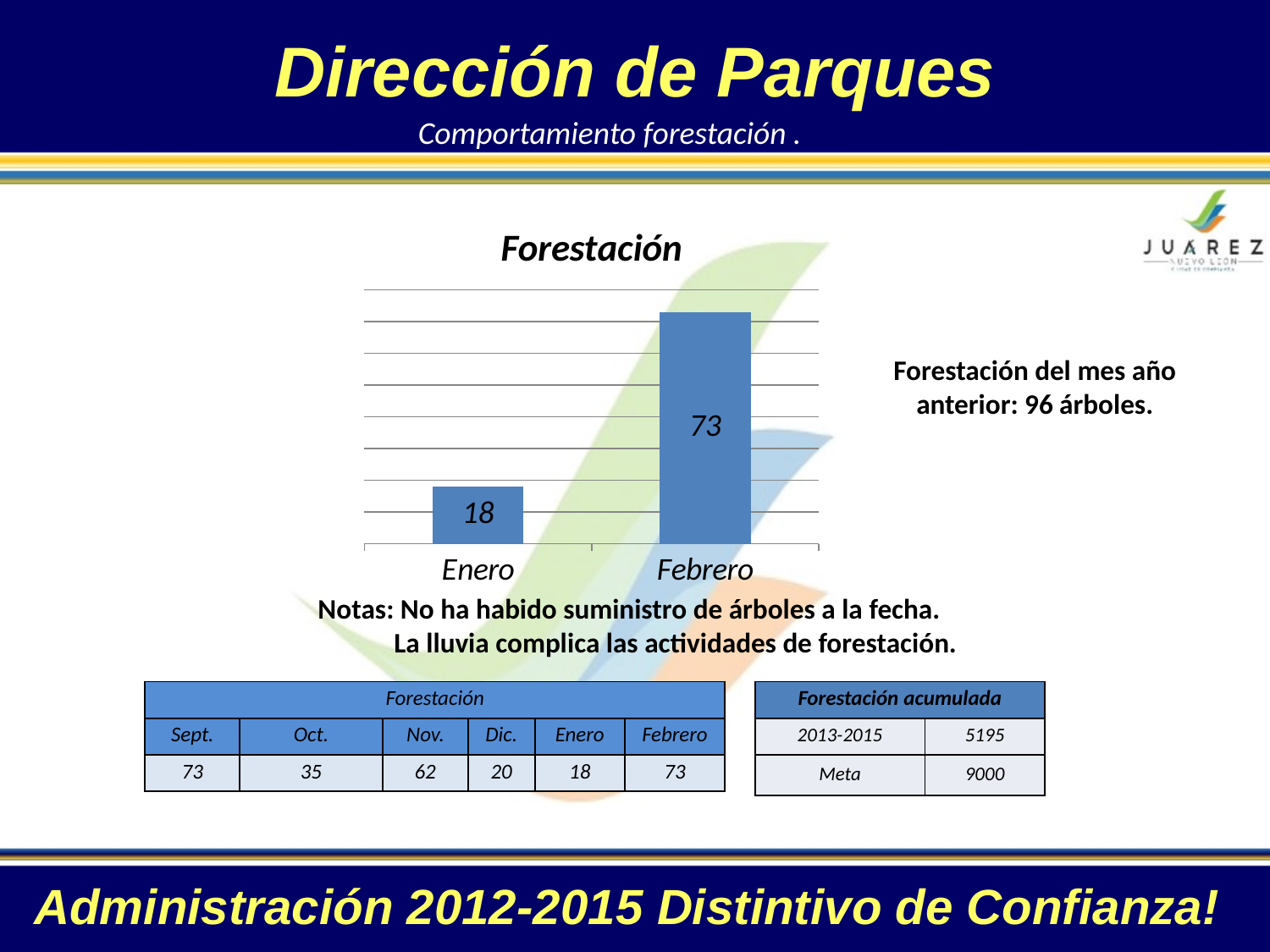
Which is larger in the Forestación chart, Enero or Febrero? Febrero What kind of chart is the Forestación chart? bar chart What is the difference between the Febrero and Enero values in the Forestación chart? 55 What colour are the bars in the Forestación chart? blue Which month has the lowest value in the Forestación chart? Enero Which month has the highest value in the Forestación chart? Febrero What is the value for Enero in the Forestación chart? 18 What is the title of the chart on the slide? Forestación What is the value for Febrero in the Forestación chart? 73 Do the values rise or fall from Enero to Febrero in the Forestación chart? rise How many categories are plotted in the Forestación chart? 2